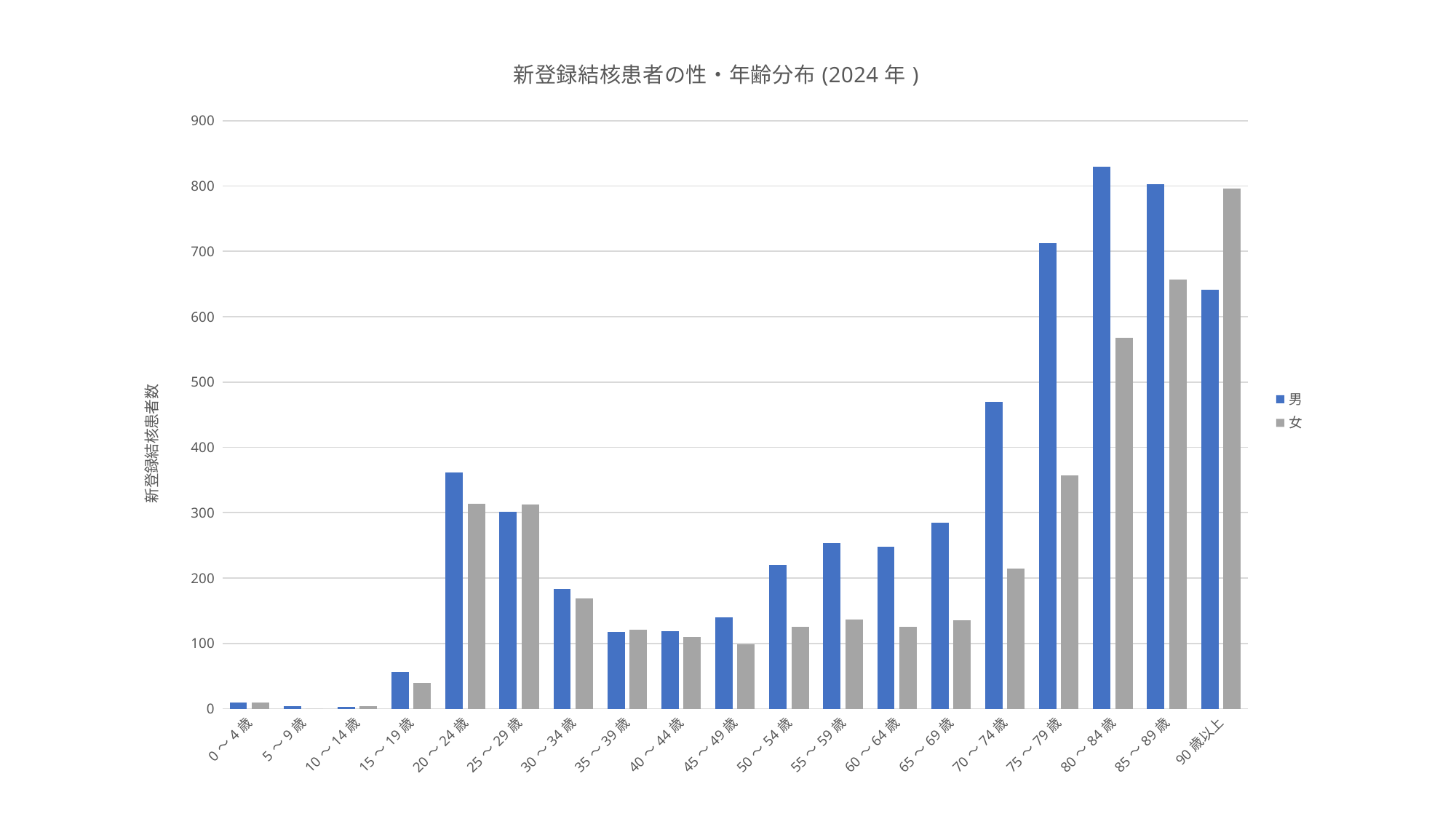
Which age category has the highest value for 男? 80～84歳 Is the value for 男 in the 80～84歳 category greater or less than 800? greater In the 90歳以上 category, which series has the larger value, 男 or 女? 女 Is the value for 男 in the 70～74歳 category greater or less than 500? less Is the value for 女 in the 80～84歳 category greater or less than 500? greater Which age category has the highest value for 女? 90歳以上 What kind of chart is shown on the slide? bar chart In the 20～24歳 category, which series has the larger value, 男 or 女? 男 How many series does the legend list? 2 How many age categories are shown on the x axis? 19 What is the title of the chart? 新登録結核患者の性・年齢分布 (2024 年 )